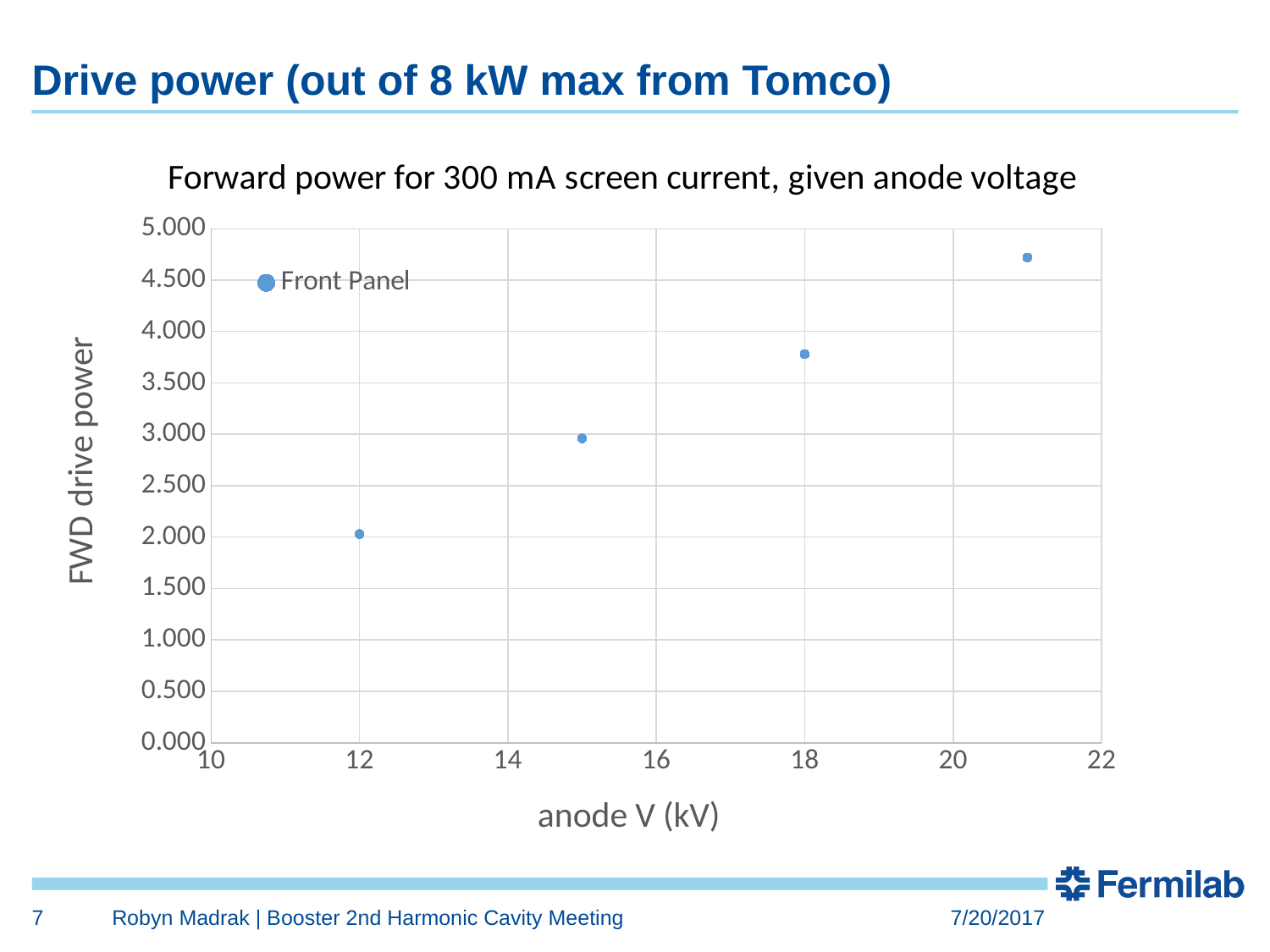
Is the FWD drive power at 18 kV greater or less than 3.500? greater Which has the larger FWD drive power, the point at 15 kV or the point at 18 kV? 18 kV How many data points are plotted on the chart? 4 Is the FWD drive power at 21 kV greater or less than 4.500? greater What is the title of the chart? Forward power for 300 mA screen current, given anode voltage Does the FWD drive power rise or fall as anode voltage increases? rise At which anode voltage (kV) is the FWD drive power lowest? 12 What is the name of the series in the legend? Front Panel What kind of chart is shown on the slide? scatter chart At which anode voltage (kV) is the FWD drive power highest? 21 Is the FWD drive power at 18 kV greater or less than 4.000? less How many series does the legend list? 1